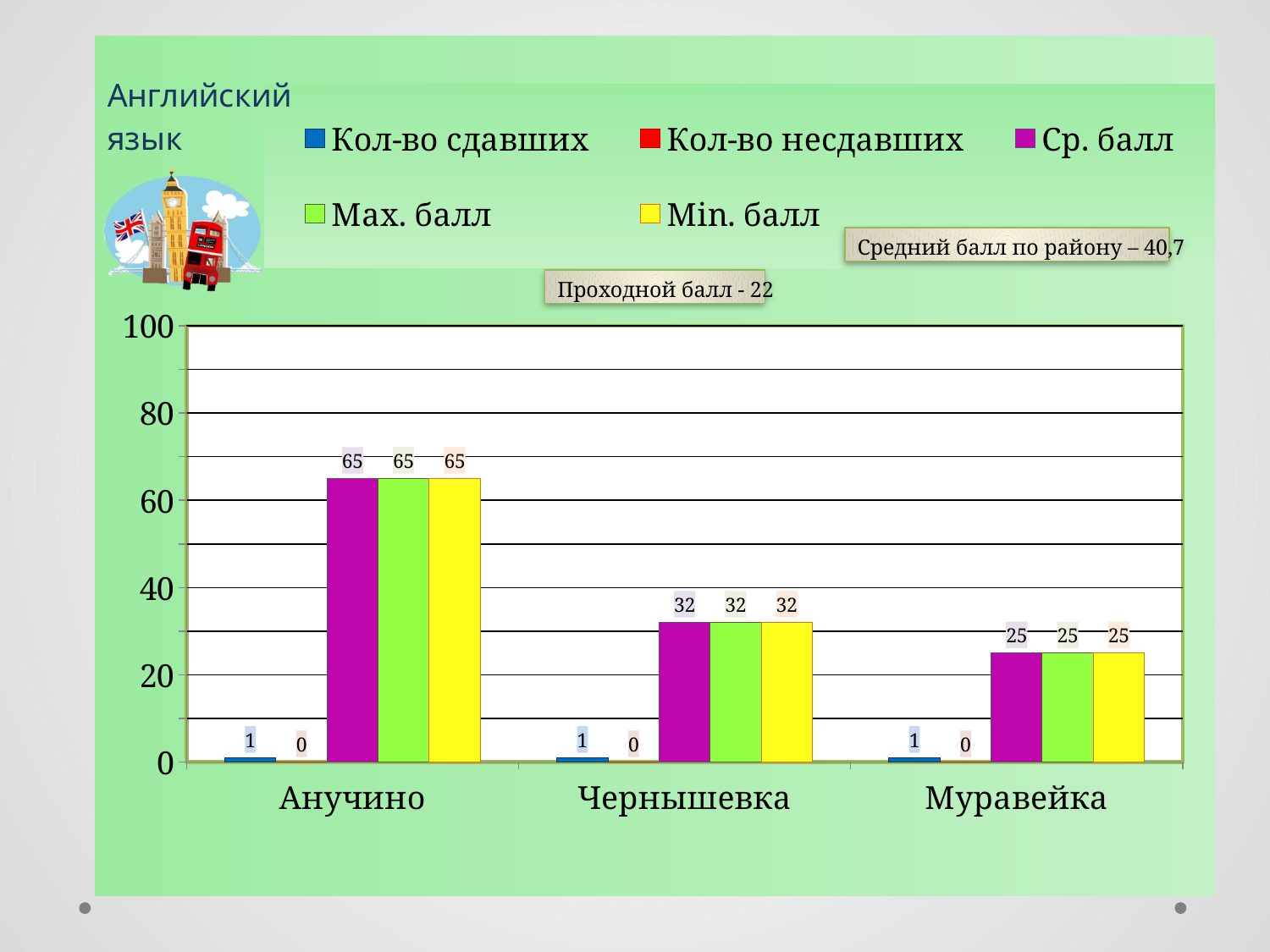
How many series does the legend list? 5 What is the Ср. балл value for Анучино? 65 What is the Кол-во несдавших value for Анучино? 0 Which is larger, the Min. балл for Чернышевка or for Муравейка? Чернышевка What kind of chart is shown on the slide? bar chart How many categories are shown on the x axis? 3 What is the Min. балл value for Муравейка? 25 What is the difference between the Ср. балл for Анучино and for Чернышевка? 33 Which category has the lowest Max. балл? Муравейка Which category has the highest Ср. балл? Анучино What is the Max. балл value for Чернышевка? 32 What is the Кол-во сдавших value for Чернышевка? 1